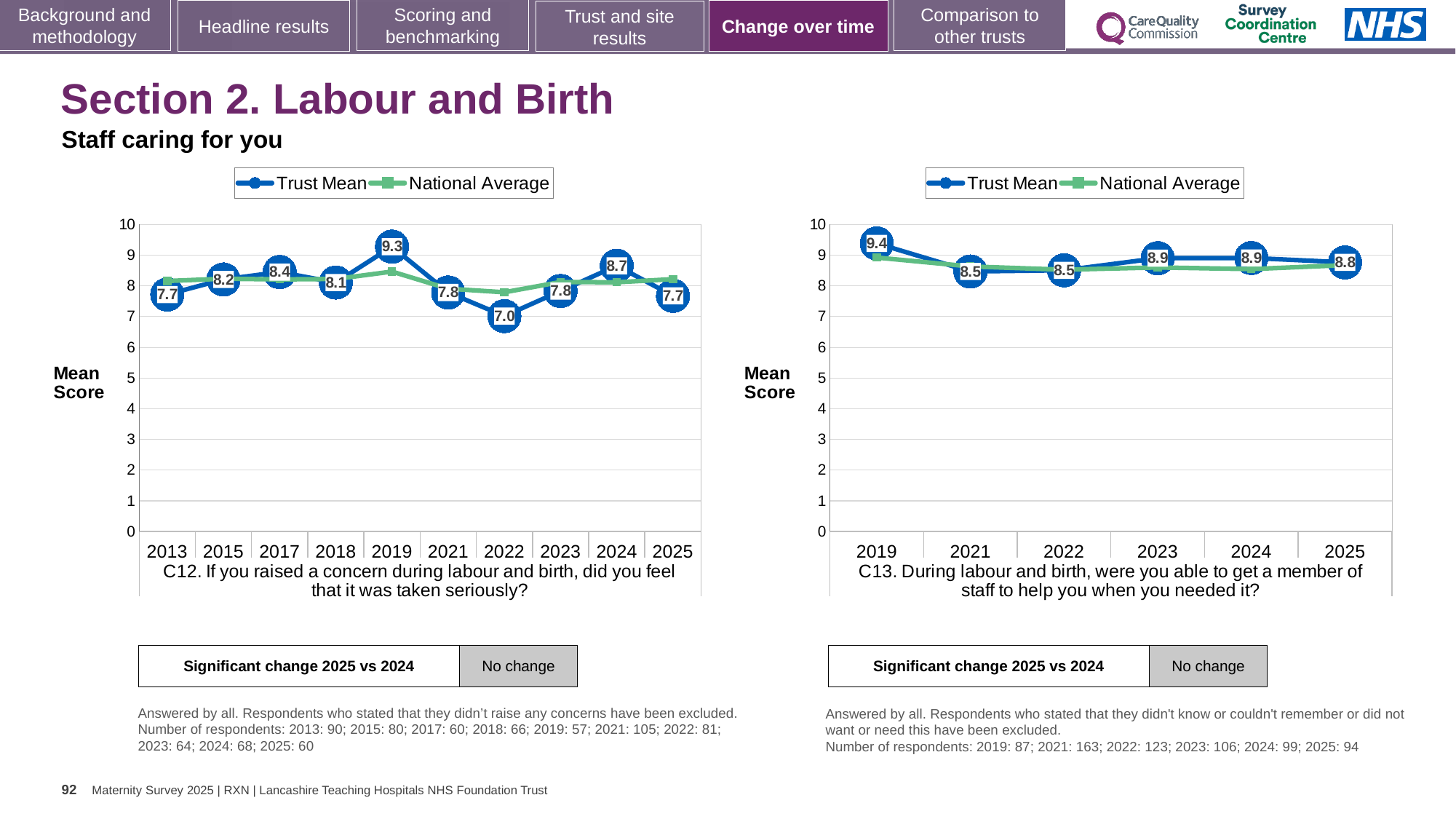
In the C12 chart (left), what is the Trust Mean score for 2022? 7.0 In the C13 chart (right), is the Trust Mean score for 2023 larger or smaller than the score for 2021? larger In the C12 chart (left), what is the Trust Mean score for 2019? 9.3 In the C12 chart (left), how many years are shown on the x axis? 10 In the C12 chart (left), what is the difference between the Trust Mean scores for 2024 and 2025? 1.0 In the C13 chart (right), which year has the highest Trust Mean score? 2019 In the C12 chart (left), which year has the lowest Trust Mean score? 2022 In the C13 chart (right), what is the Trust Mean score for 2019? 9.4 What type of chart is the C12 chart (left)? Line chart In the C13 chart (right), what is the Trust Mean score for 2025? 8.8 In the C12 chart (left), which year has the highest Trust Mean score? 2019 In the C13 chart (right), how many series does the legend list? 2